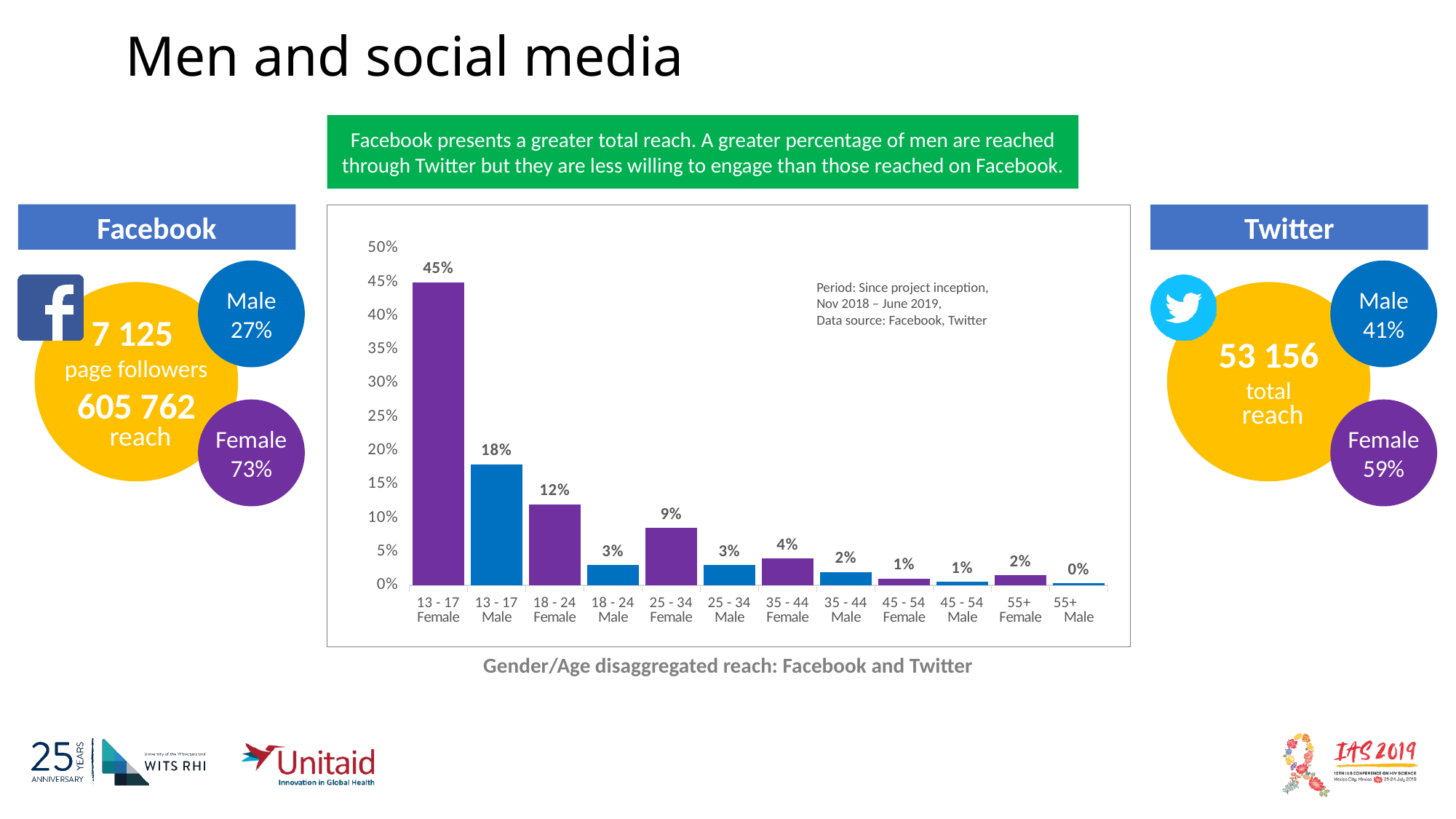
Which category has the highest value? 13 - 17 Female Is the value for 13 - 17 Male greater or less than 15%? greater What is the difference between the values for 18 - 24 Female and 18 - 24 Male? 9% What is the value for 13 - 17 Female? 45% What is the value for 25 - 34 Female? 9% Which category has the lowest value? 55+ Male What is the value for 35 - 44 Male? 2% What is the caption printed below the chart? Gender/Age disaggregated reach: Facebook and Twitter How many categories are shown on the x axis? 12 Which is larger, the value for 25 - 34 Female or the value for 35 - 44 Female? 25 - 34 Female What kind of chart is shown on the slide? bar chart What is the difference between the values for 13 - 17 Female and 13 - 17 Male? 27%